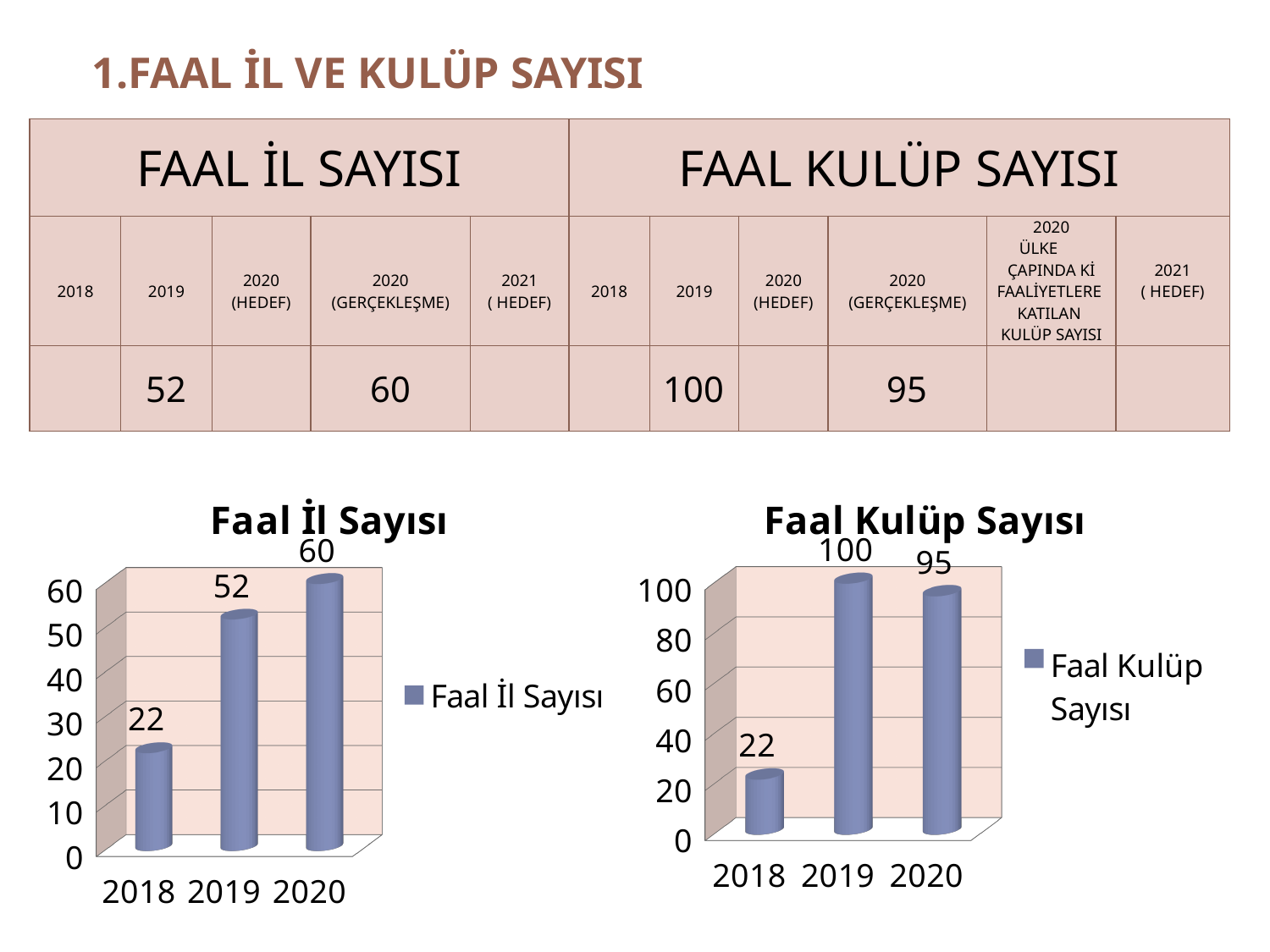
In the 'Faal Kulüp Sayısı' chart, which year has the lowest value? 2018 In the 'Faal Kulüp Sayısı' chart, which is larger, the value for 2019 or the value for 2020? 2019 In the 'Faal İl Sayısı' chart, what is the difference between the values for 2020 and 2018? 38 In the 'Faal İl Sayısı' chart, what is the value for 2019? 52 In the 'Faal İl Sayısı' chart, which year has the highest value? 2020 In the 'Faal Kulüp Sayısı' chart, what is the difference between the values for 2019 and 2020? 5 In the 'Faal İl Sayısı' chart, do the values rise or fall from 2018 to 2020? Rise In the 'Faal Kulüp Sayısı' chart, what is the value for 2020? 95 What kind of chart is the 'Faal Kulüp Sayısı' chart? Bar chart How many series does the legend of the 'Faal İl Sayısı' chart list? 1 In the 'Faal İl Sayısı' chart, is the value for 2019 greater or less than 40? greater How many years are shown on the x axis of the 'Faal Kulüp Sayısı' chart? 3